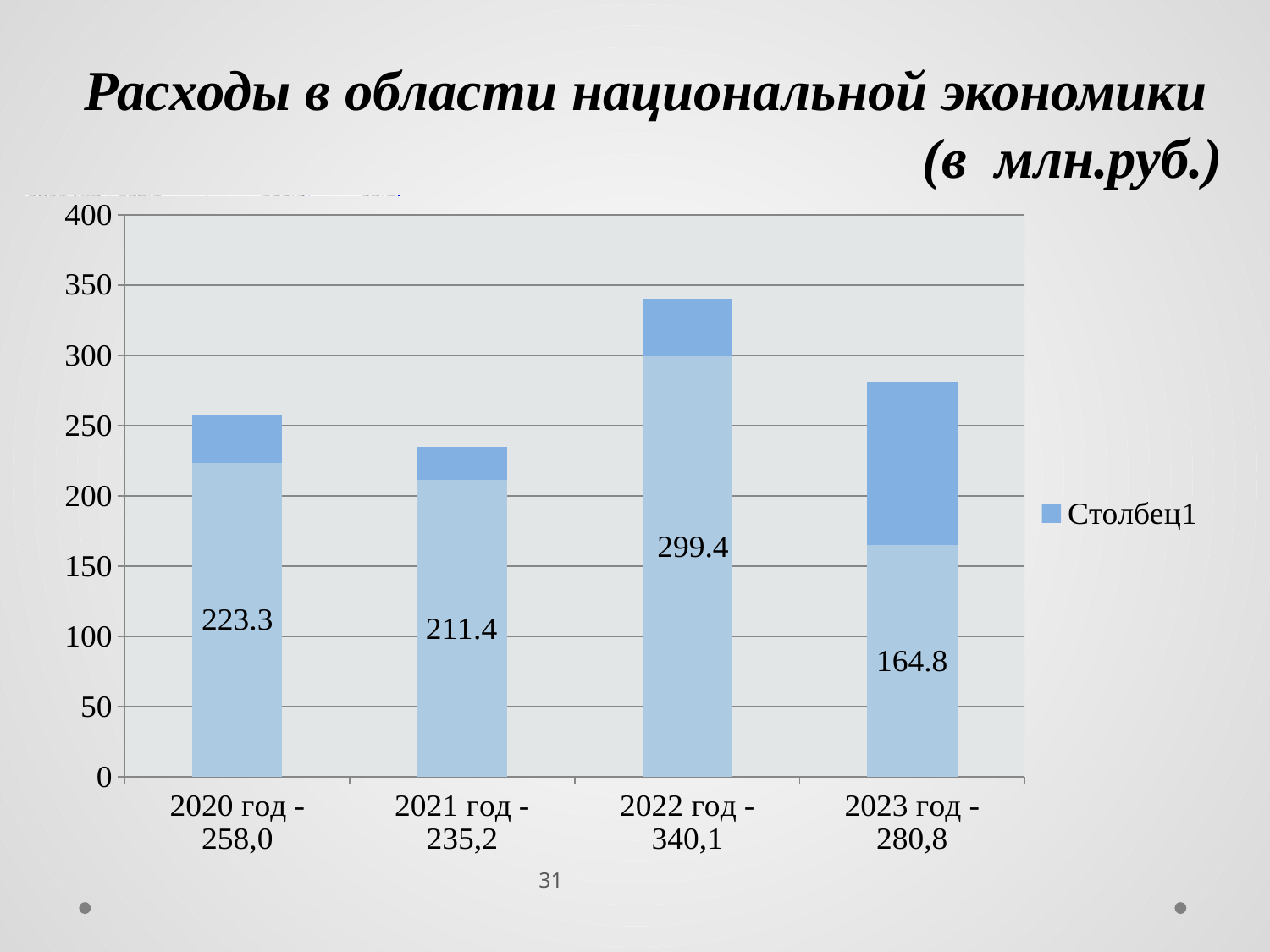
Which is larger, the labelled lower-segment value for 2020 год or for 2021 год? 2020 год What is the difference between the labelled lower-segment values for 2022 год and 2020 год? 76.1 What is the labelled value of the lower segment for 2020 год? 223.3 What is the labelled value of the lower segment for 2022 год? 299.4 Which year has the lowest labelled lower-segment value? 2023 год How many years (categories) are shown on the chart? 4 Which year has the highest labelled lower-segment value? 2022 год What total is shown in the category label for 2023 год? 280,8 How many series does the legend list? 1 What kind of chart is shown on the slide? bar chart What is the labelled value of the lower segment for 2023 год? 164.8 Is the total height of the 2022 год bar greater or less than 300? greater